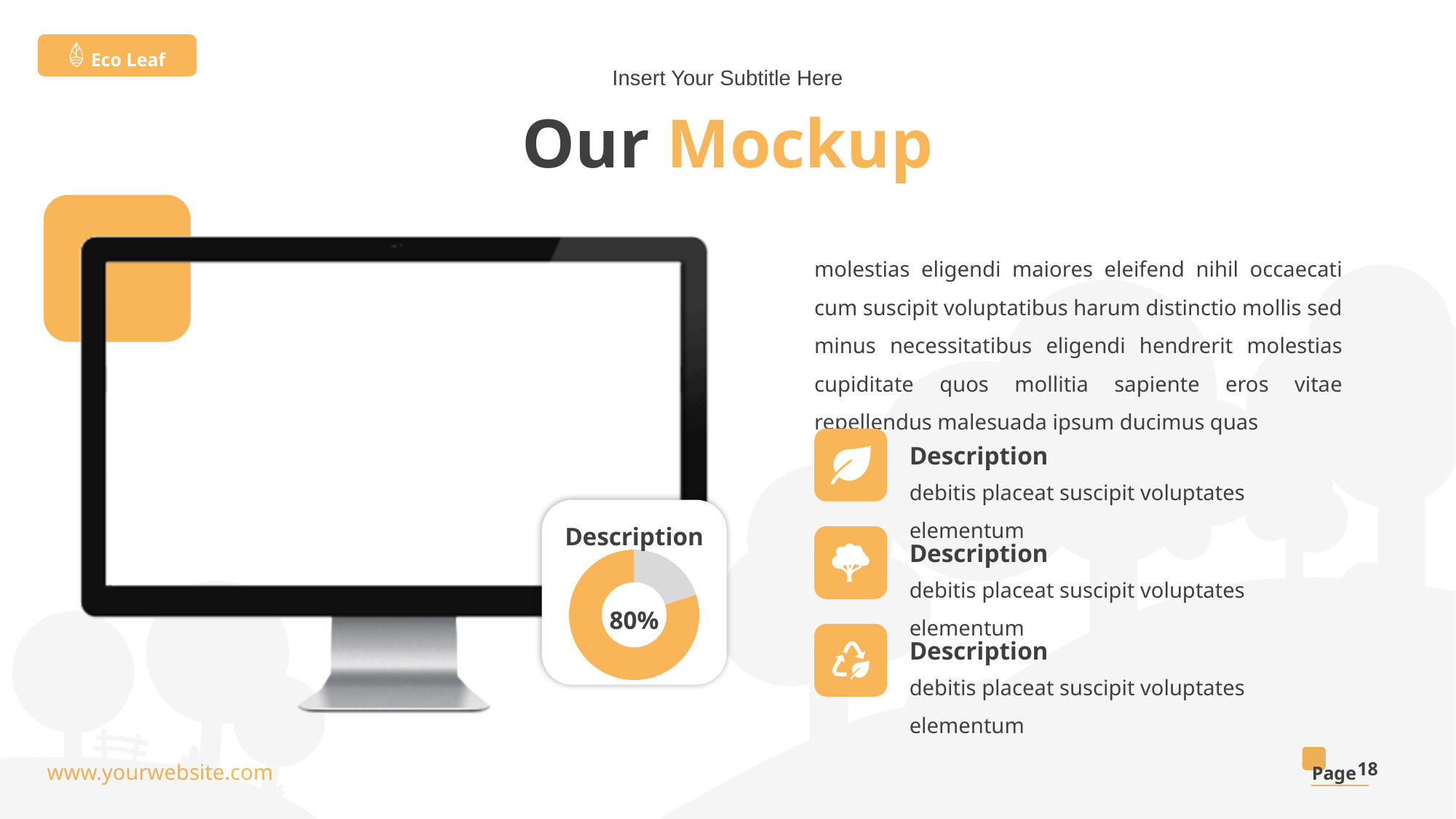
What colour is the larger slice of the donut chart? Orange Which slice of the donut chart is larger, the orange one or the grey one? Orange What kind of chart is shown on the slide? Donut chart What percentage is printed in the centre of the donut chart? 80% What is the title shown above the donut chart? Description What share of the donut chart does the orange slice represent? 80% How many slices does the donut chart have? 2